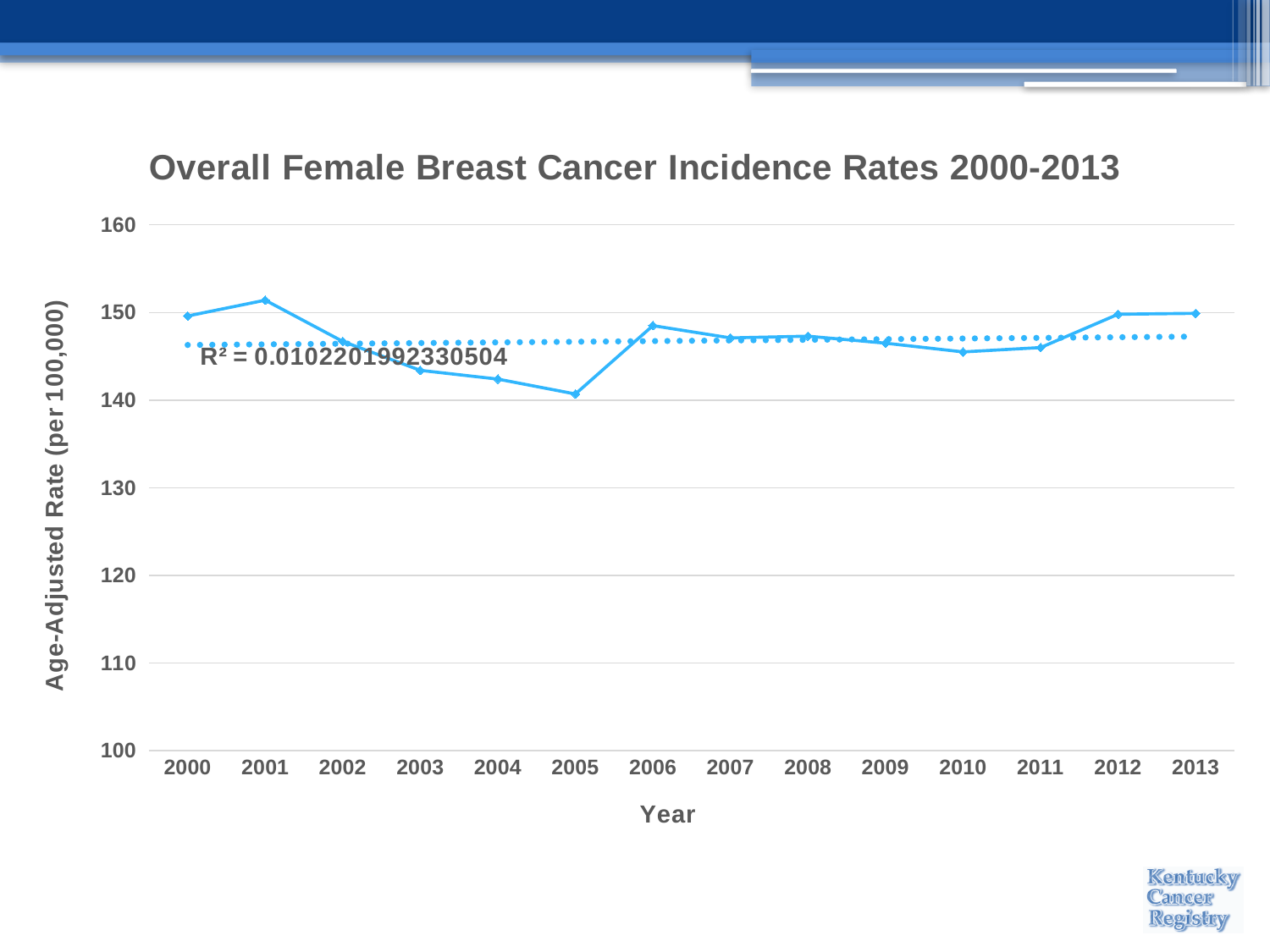
Is the value for 2003 greater or less than 150? less Do the values rise or fall from 2001 to 2005? fall What is the title of the chart? Overall Female Breast Cancer Incidence Rates 2000-2013 Which year has the lowest incidence rate? 2005 Which year has the larger incidence rate, 2006 or 2005? 2006 What R² value is printed on the chart for the trend line? 0.0102201992330504 How many years are plotted along the x axis? 14 Is the value for 2004 greater or less than 140? greater What kind of chart is shown on the slide? line chart Which year has the larger incidence rate, 2000 or 2003? 2000 Which year has the highest incidence rate? 2001 Is the value for 2001 greater or less than 150? greater